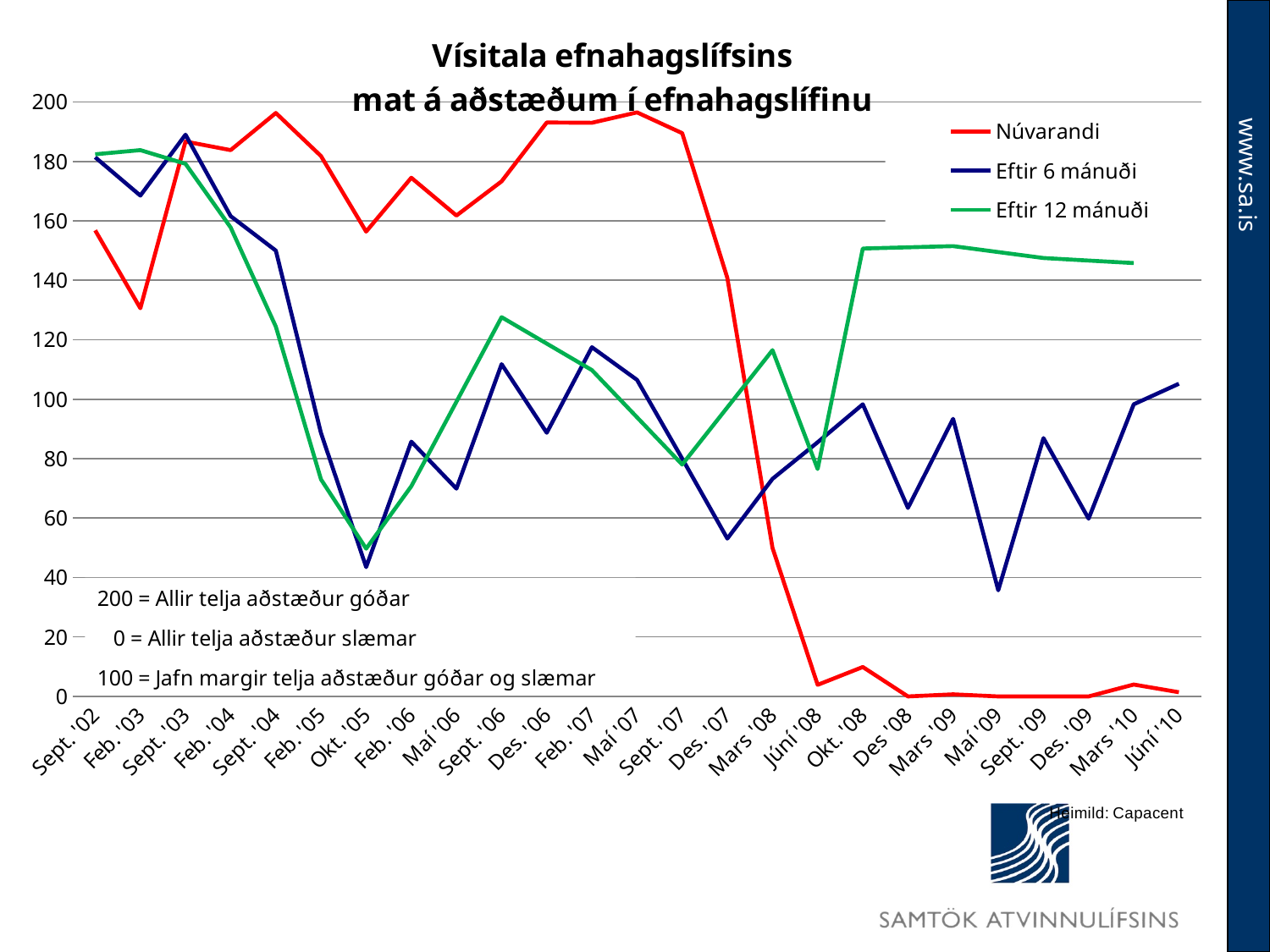
Is the value for Eftir 6 mánuði at Okt '05 greater or less than 60? less What colour is the Núvarandi line in the legend? Red Is the value for Núvarandi at Júní '10 greater or less than 20? less Which series has the lowest value at Júní '10? Núvarandi Is the value for Eftir 12 mánuði at Okt '08 greater or less than 140? greater At Sept '04, which is larger: Núvarandi or Eftir 6 mánuði? Núvarandi What kind of chart is shown on the slide? Line chart How many series does the legend list? 3 Does the Núvarandi line rise or fall between Sept '07 and Júní '08? Fall How many time points are shown along the x axis? 25